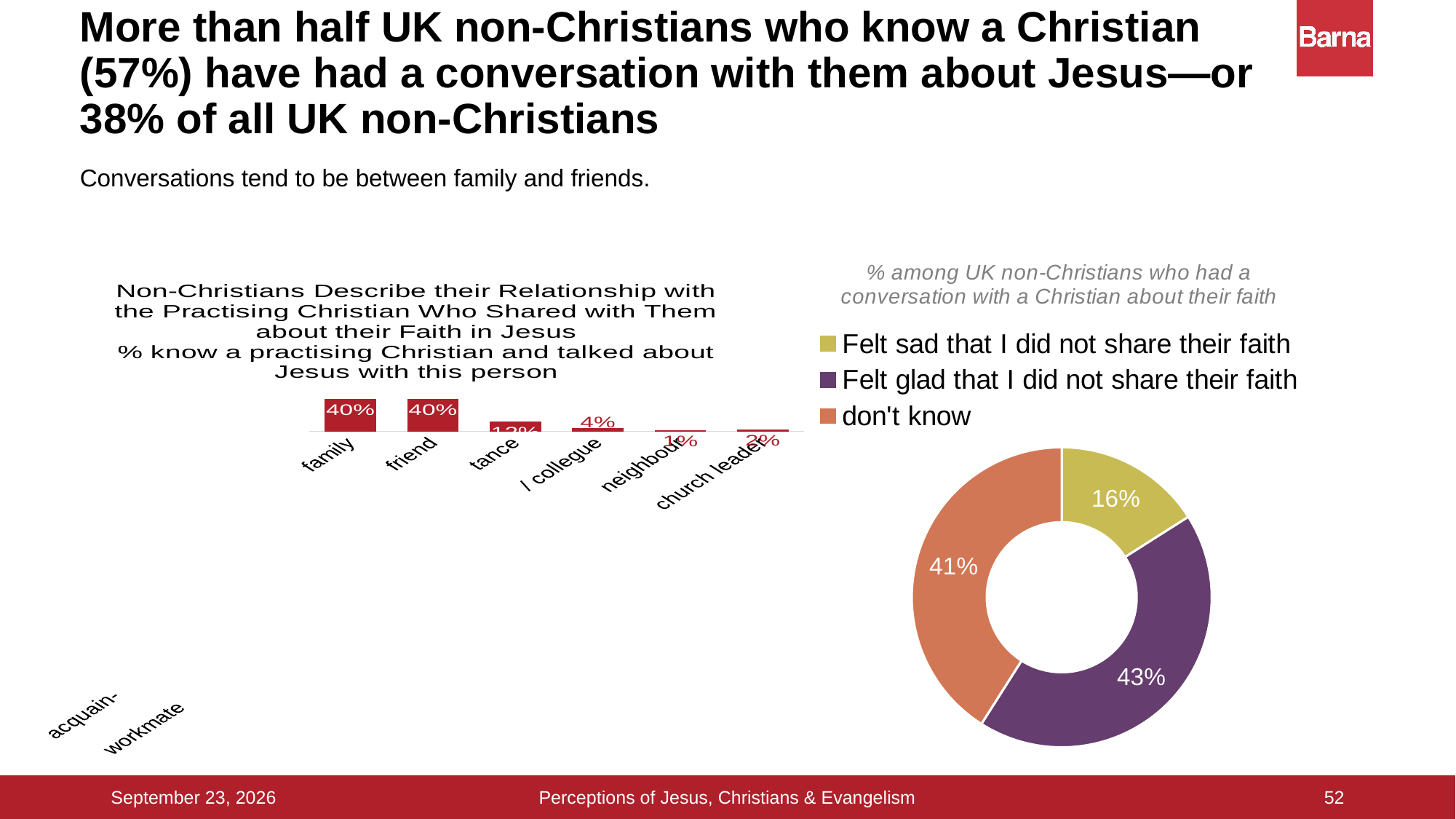
In the donut chart on the right, what percentage answered 'don't know'? 41% How many entries does the legend of the donut chart on the right list? 3 What kind of chart is shown on the left side of the slide? Bar chart In the bar chart on the left, what percentage talked about Jesus with a family member? 40% In the bar chart on the left, which is larger: the value for family or the value for neighbour? family In the donut chart on the right, which response has the largest share? Felt glad that I did not share their faith In the donut chart on the right, what is the difference between the 'Felt glad' share and the 'Felt sad' share? 27 percentage points What kind of chart is shown on the right side of the slide? Donut (pie) chart In the bar chart on the left, what percentage talked about Jesus with a friend? 40% In the donut chart on the right, what percentage felt glad that they did not share their faith? 43% In the donut chart on the right, what percentage felt sad that they did not share their faith? 16% In the donut chart on the right, which response has the smallest share? Felt sad that I did not share their faith